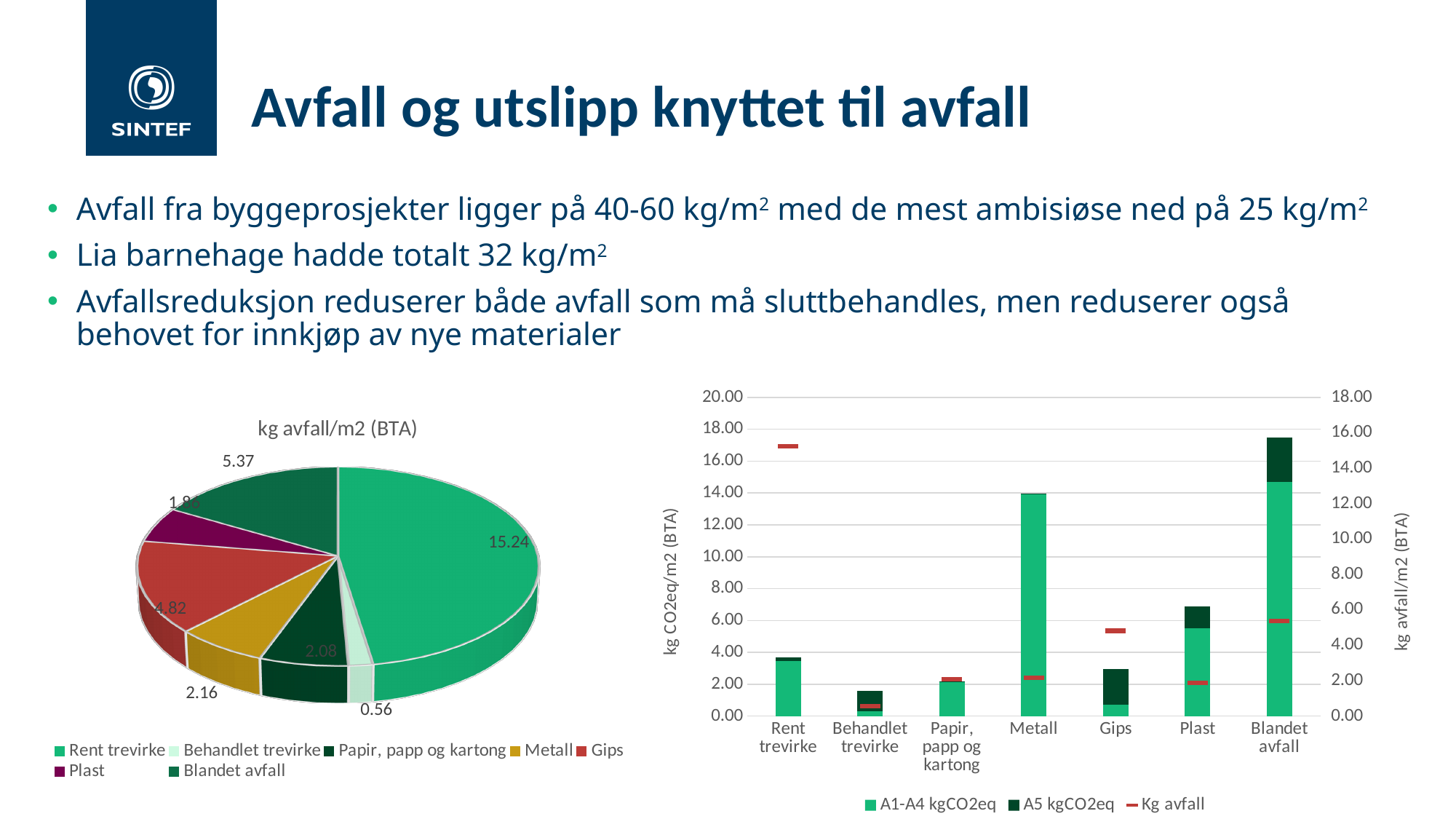
On the pie chart titled 'kg avfall/m2 (BTA)', what is the difference between the values for Rent trevirke and Behandlet trevirke? 14.68 On the pie chart titled 'kg avfall/m2 (BTA)', which category has the largest slice? Rent trevirke How many slices does the pie chart titled 'kg avfall/m2 (BTA)' have? 7 On the bar chart on the right, is the total stacked bar for Blandet avfall greater or less than 16.00 on the left axis? greater On the pie chart titled 'kg avfall/m2 (BTA)', what is the value for Gips? 4.82 On the pie chart titled 'kg avfall/m2 (BTA)', what is the value for Blandet avfall? 5.37 How many series does the legend of the bar chart on the right list? 3 On the pie chart titled 'kg avfall/m2 (BTA)', which is larger, Gips or Blandet avfall? Blandet avfall On the pie chart titled 'kg avfall/m2 (BTA)', what is the value for Rent trevirke? 15.24 On the pie chart titled 'kg avfall/m2 (BTA)', which category has the smallest slice? Behandlet trevirke What kind of chart is the chart on the right side of the slide? Bar chart On the bar chart on the right, is the total stacked bar for Behandlet trevirke greater or less than 2.00 on the left axis? less